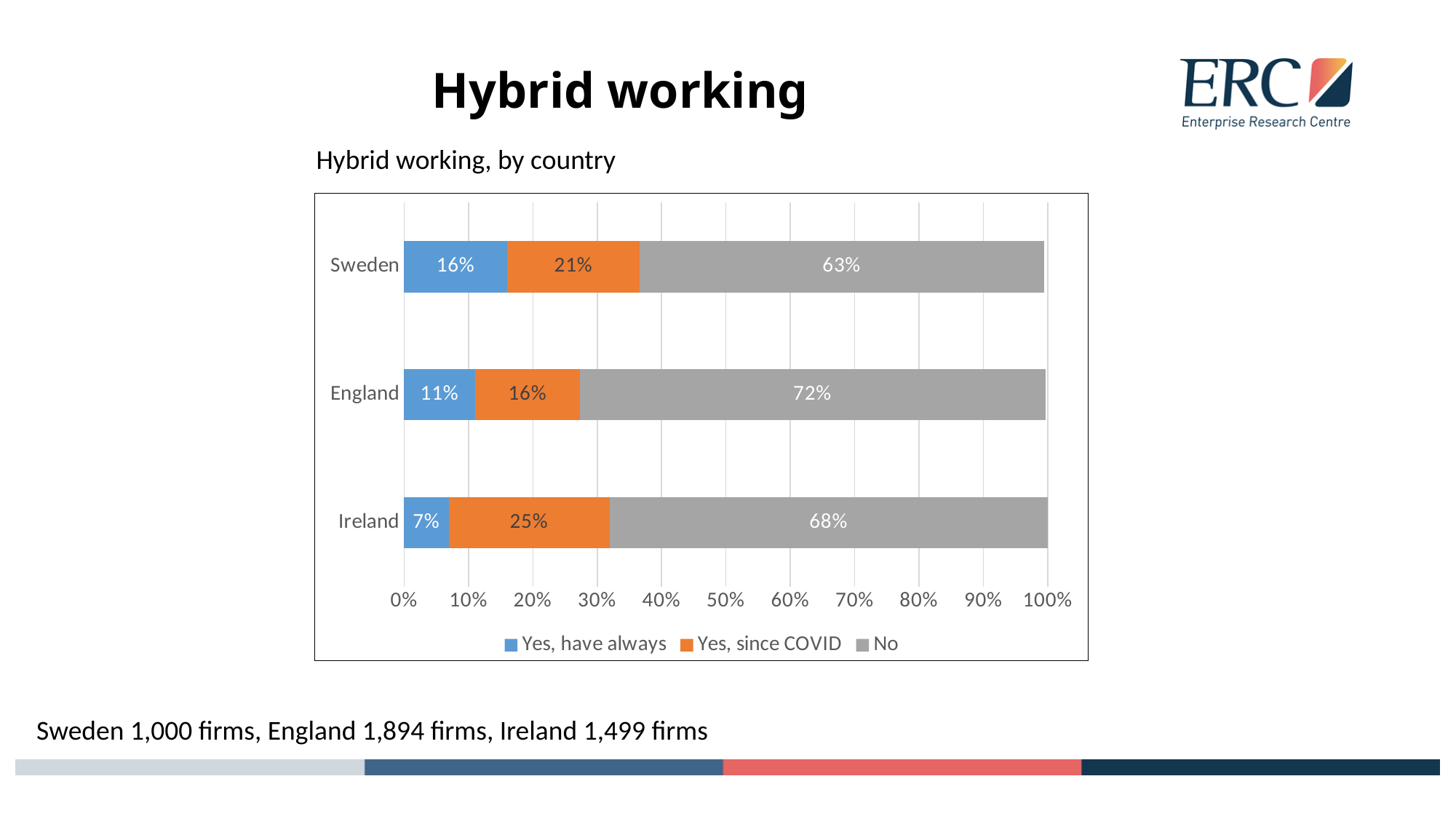
Is the "No" share for Sweden greater or less than 60%? greater What kind of chart is shown on the slide? Stacked bar chart Which country has the highest share of firms answering "No"? England What is the title of the chart? Hybrid working, by country What percentage of firms in Ireland answered "Yes, since COVID"? 25% How many series does the legend list? 3 Which country has the lowest share of firms answering "Yes, have always"? Ireland How many countries are shown in the chart? 3 What is the difference between the "Yes, since COVID" shares for Ireland and England? 9 percentage points Which is larger: the "Yes, have always" share for Sweden or for England? Sweden What percentage of firms in England answered "No"? 72% What percentage of firms in Sweden answered "Yes, have always"? 16%